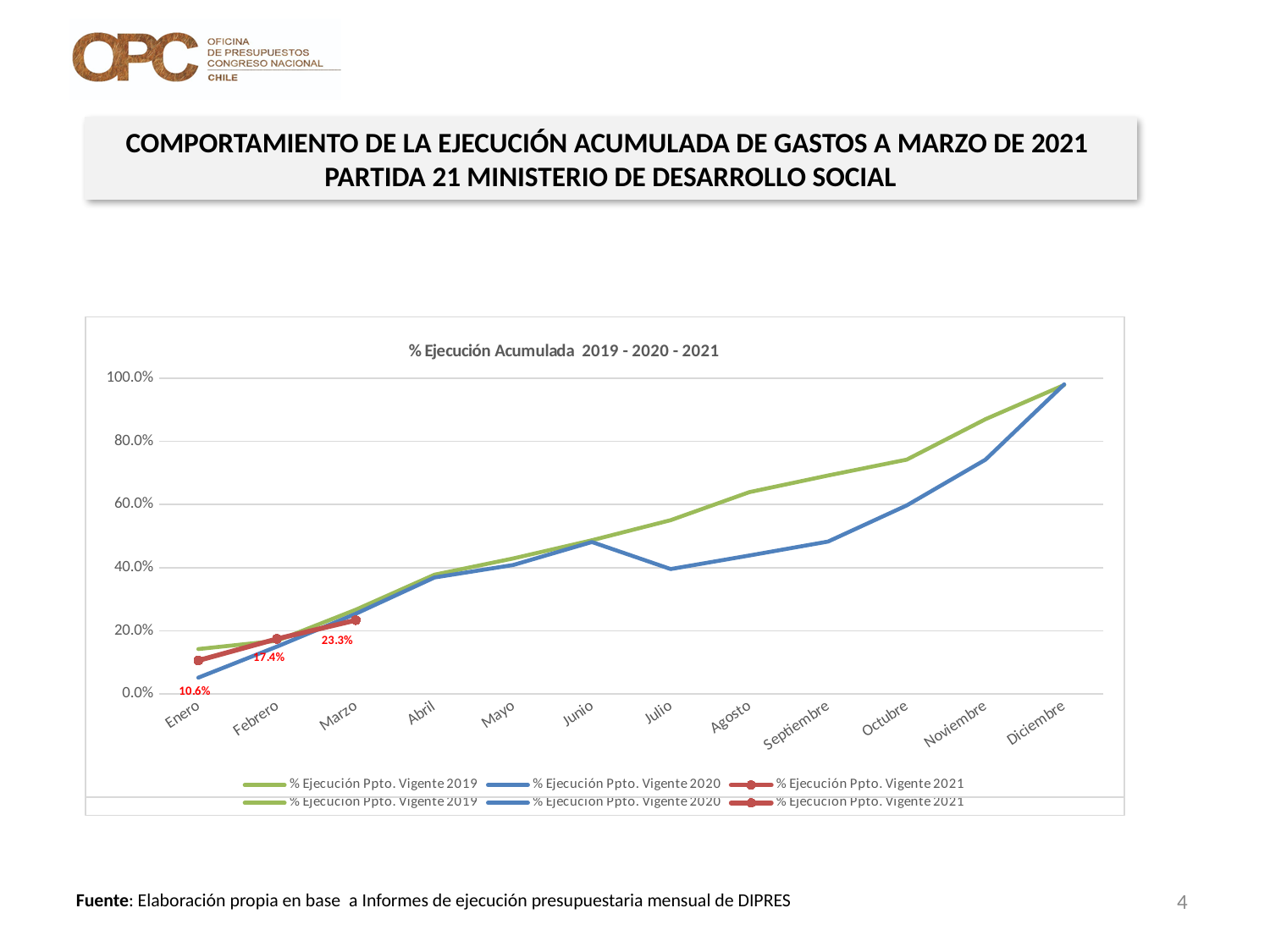
How many series does the chart's legend list? 3 What is the value for Marzo in the % Ejecución Ppto. Vigente 2021 series? 23.3% What is the title of the chart? % Ejecución Acumulada 2019 - 2020 - 2021 What is the value for Febrero in the % Ejecución Ppto. Vigente 2021 series? 17.4% What kind of chart is shown on the slide? Line chart In Julio, which series has the larger value: % Ejecución Ppto. Vigente 2019 or % Ejecución Ppto. Vigente 2020? % Ejecución Ppto. Vigente 2019 Which month has the highest value in the % Ejecución Ppto. Vigente 2021 series? Marzo By how many percentage points did the 2021 series increase from Enero to Marzo? 12.7 percentage points Is the value for Octubre in the % Ejecución Ppto. Vigente 2019 series greater or less than 60.0%? greater Does the % Ejecución Ppto. Vigente 2021 series rise or fall from Enero to Marzo? Rises How many months are shown on the x axis of the chart? 12 What is the value for Enero in the % Ejecución Ppto. Vigente 2021 series? 10.6%